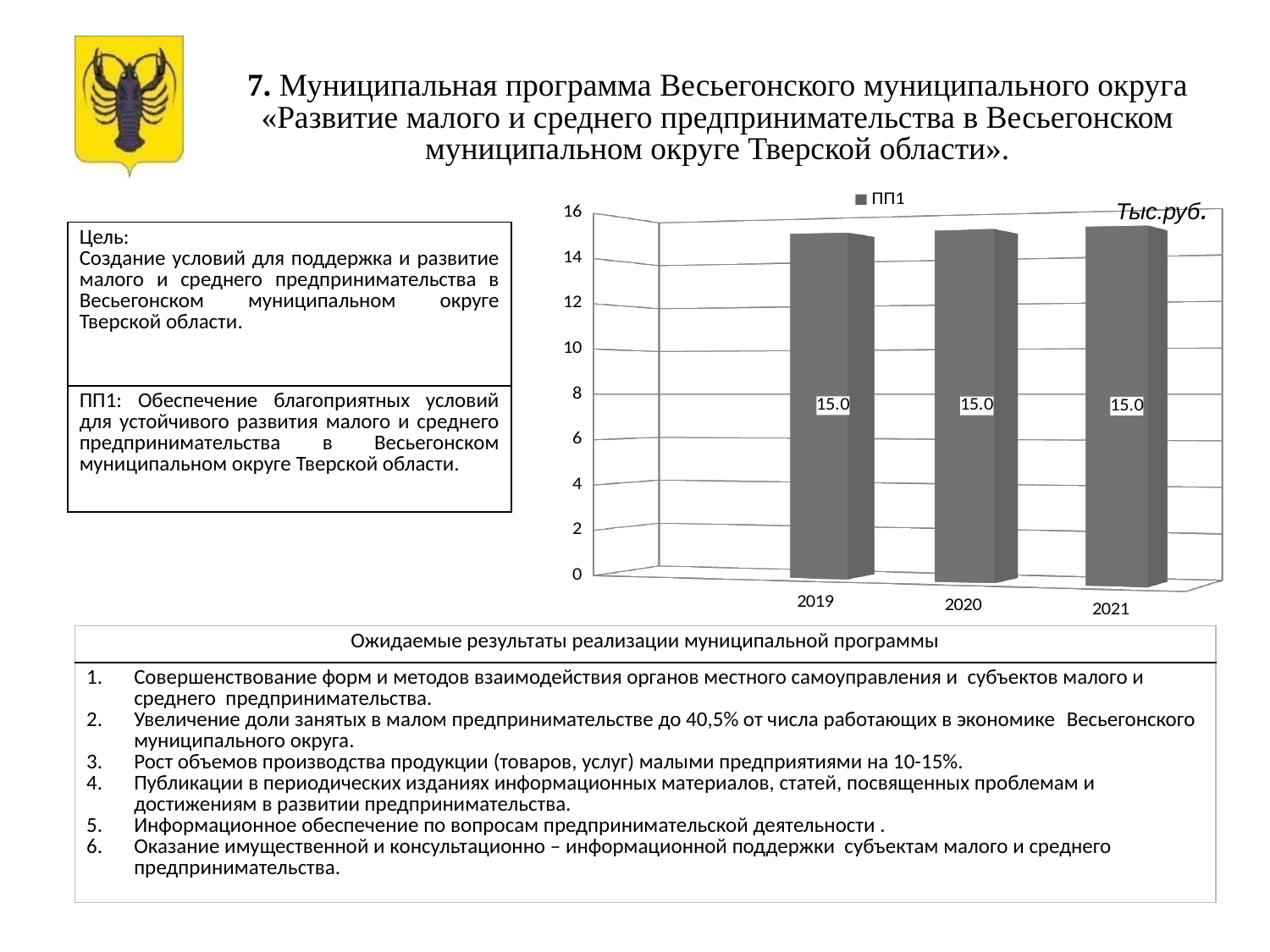
What is the difference between the values for 2021 and 2019? 0.0 What is the value for 2020 in the chart? 15.0 Do the values rise, fall or stay the same from 2019 to 2021? stay the same What unit is indicated in the top right corner of the chart? Тыс.руб. What is the value for 2021 in the chart? 15.0 What series name is shown in the chart legend? ПП1 How many years (categories) are shown on the x axis of the chart? 3 Is the value for 2019 greater or less than 16? less What kind of chart is shown on the slide? bar chart What is the value for 2019 in the chart? 15.0 How many series does the chart legend list? 1 Is the value for 2020 greater or less than 10? greater